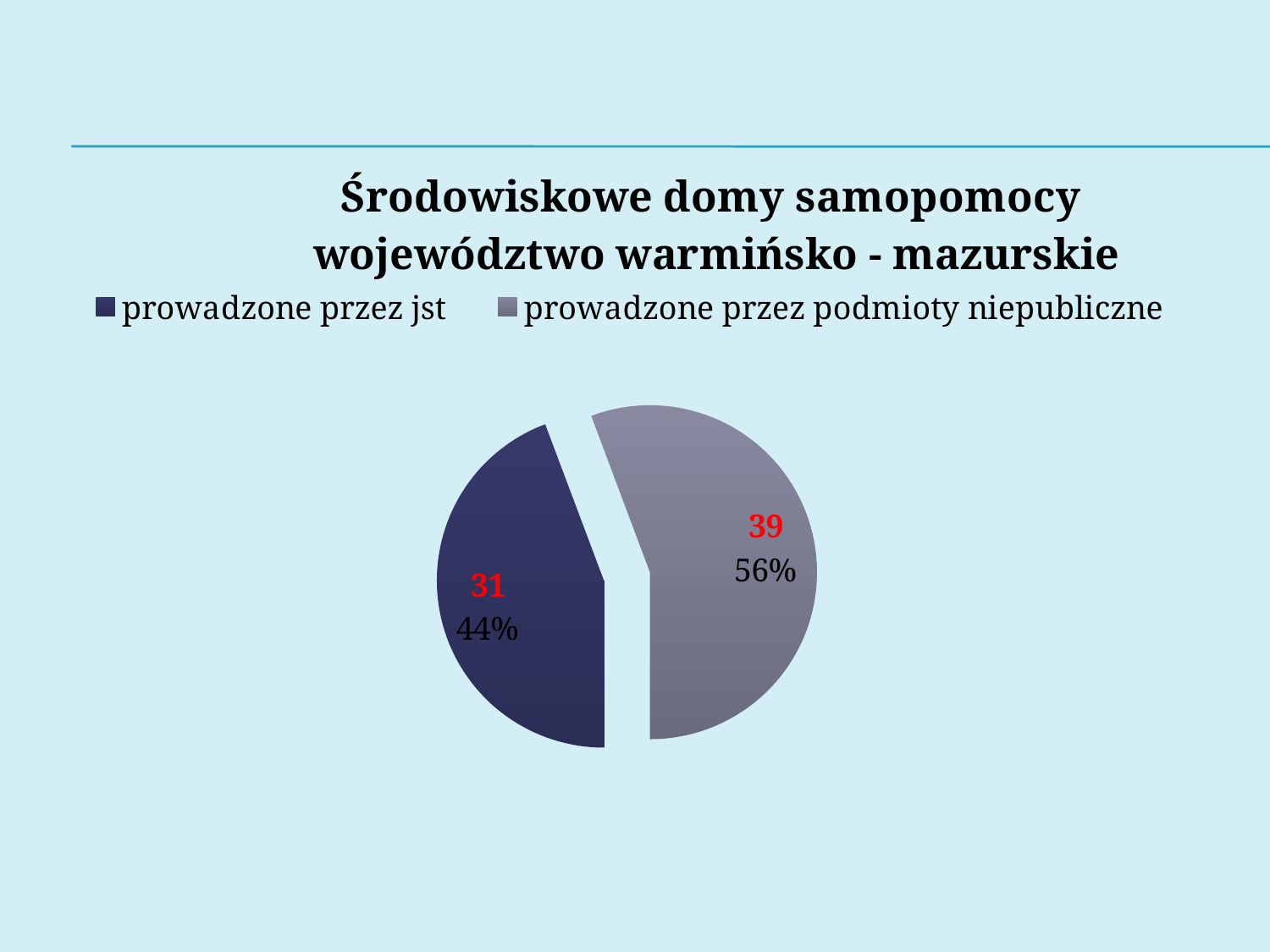
What kind of chart is shown on the slide? pie chart What is the difference between the values for 'prowadzone przez podmioty niepubliczne' and 'prowadzone przez jst'? 8 What share of the pie does 'prowadzone przez podmioty niepubliczne' represent? 56% What is the value for 'prowadzone przez jst'? 31 Which category has the smallest slice? prowadzone przez jst How many slices does the pie chart have? 2 Which is larger: 'prowadzone przez jst' or 'prowadzone przez podmioty niepubliczne'? prowadzone przez podmioty niepubliczne What share of the pie does 'prowadzone przez jst' represent? 44% What is the value for 'prowadzone przez podmioty niepubliczne'? 39 Which category has the largest slice? prowadzone przez podmioty niepubliczne What is the total of the two values shown in the pie chart? 70 What is the title of the chart? Środowiskowe domy samopomocy województwo warmińsko - mazurskie